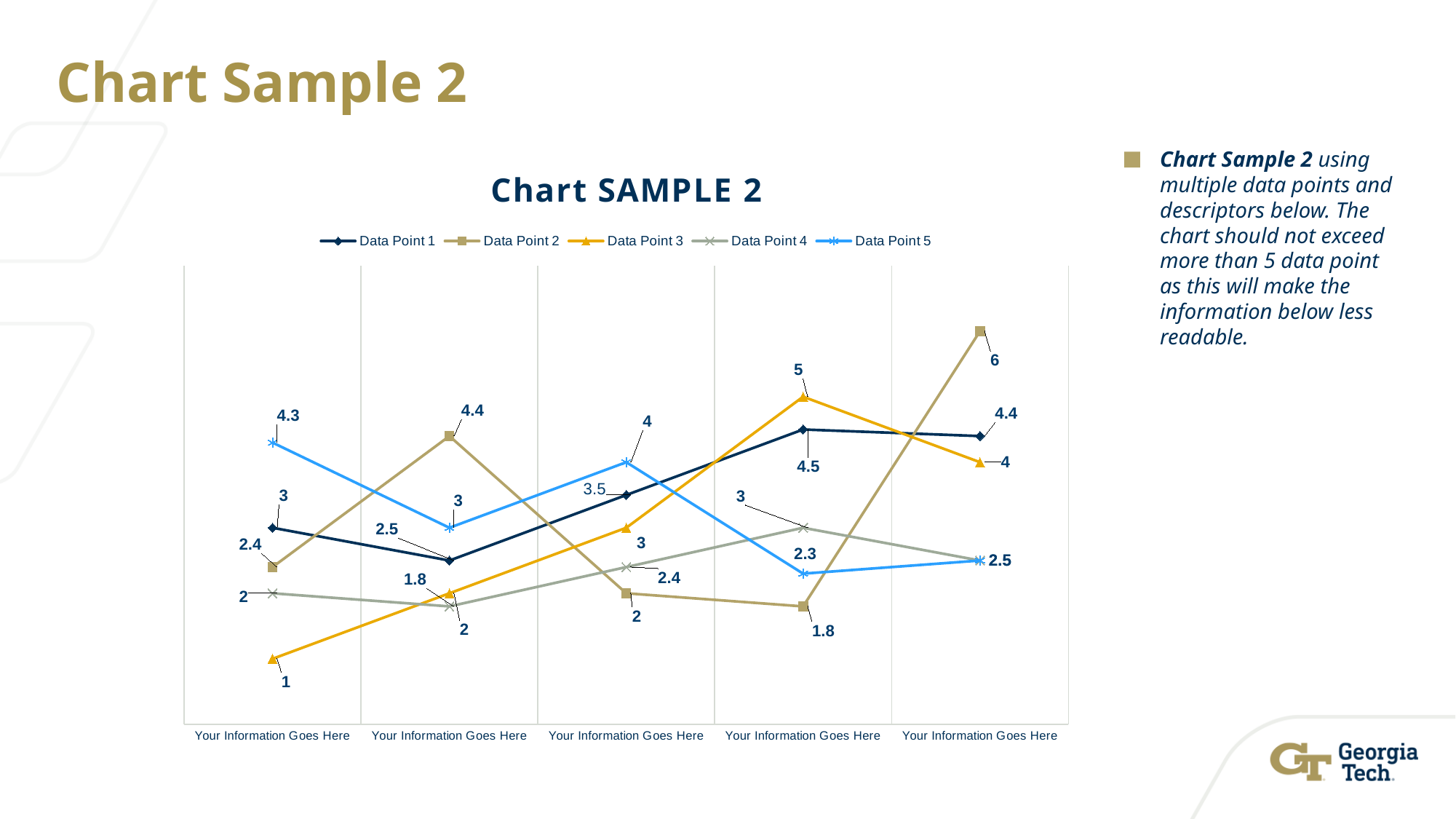
What is the value of Data Point 3 at the first category? 1 What is the value of Data Point 1 at the fourth category? 4.5 At the first category, which is larger: Data Point 5 or Data Point 1? Data Point 5 How many series does the chart legend list? 5 What is the value of Data Point 2 at the fifth (last) category? 6 What is the difference between Data Point 2's value at the fifth category and its value at the fourth category? 4.2 At which category does Data Point 3 reach its lowest value? the first category What kind of chart is shown on the slide? line chart What is the title of the chart? Chart SAMPLE 2 Which series reaches the highest value anywhere on the chart? Data Point 2 What is the value of Data Point 5 at the first category? 4.3 How many categories are plotted along the x axis? 5